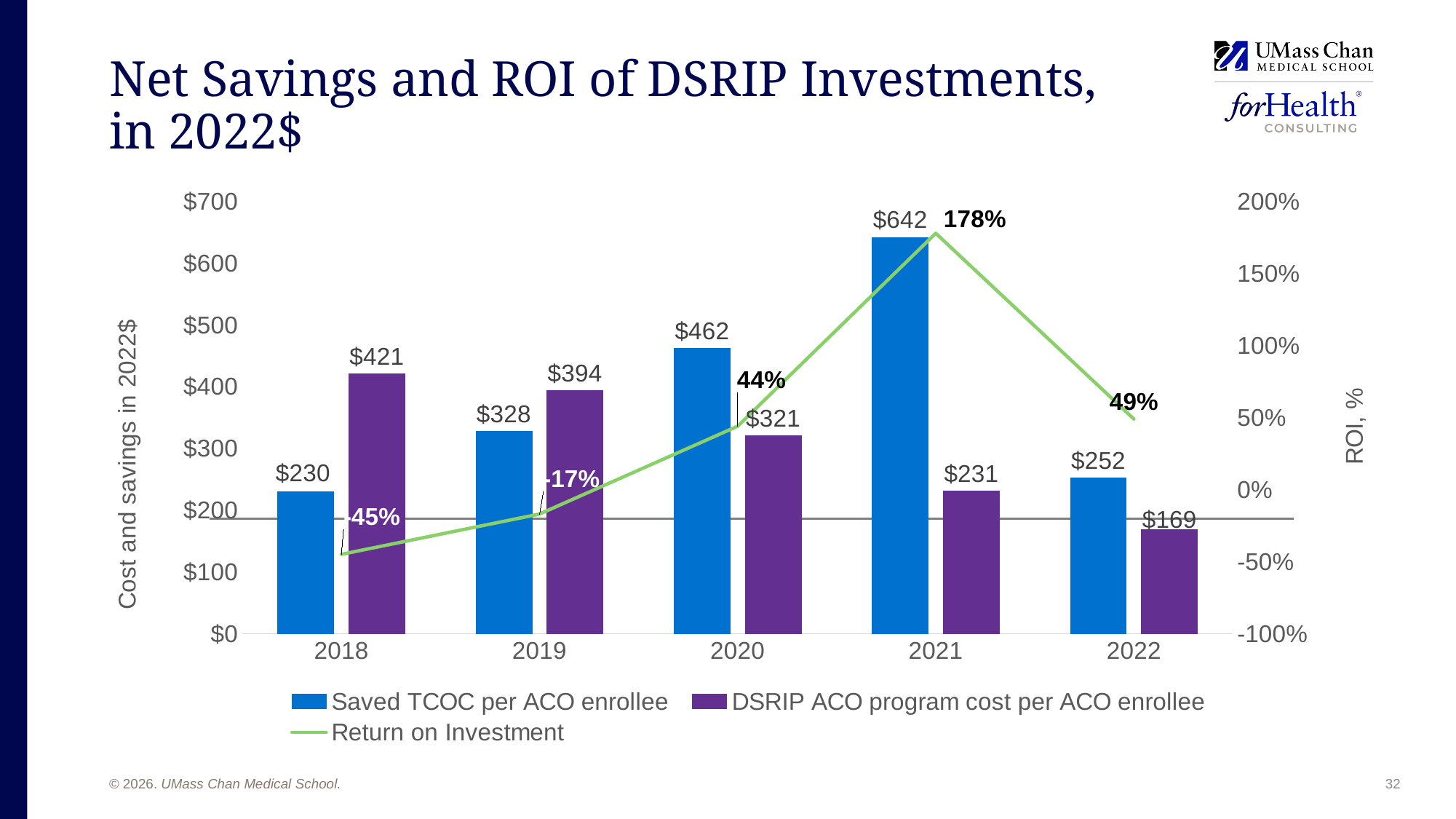
How does the DSRIP ACO program cost per ACO enrollee change from 2018 to 2022? It falls What was the Return on Investment in 2020? 44% In which year was the Saved TCOC per ACO enrollee highest? 2021 What is the difference between the Saved TCOC per ACO enrollee and the DSRIP ACO program cost per ACO enrollee in 2021? $411 How many series does the legend list? 3 What was the Saved TCOC per ACO enrollee in 2021? $642 In which year was the DSRIP ACO program cost per ACO enrollee lowest? 2022 What is the label of the right-hand vertical axis? ROI, % How many years are shown on the x axis? 5 In which year was the Return on Investment lowest? 2018 In 2019, which was larger: the Saved TCOC per ACO enrollee or the DSRIP ACO program cost per ACO enrollee? DSRIP ACO program cost per ACO enrollee What was the DSRIP ACO program cost per ACO enrollee in 2018? $421